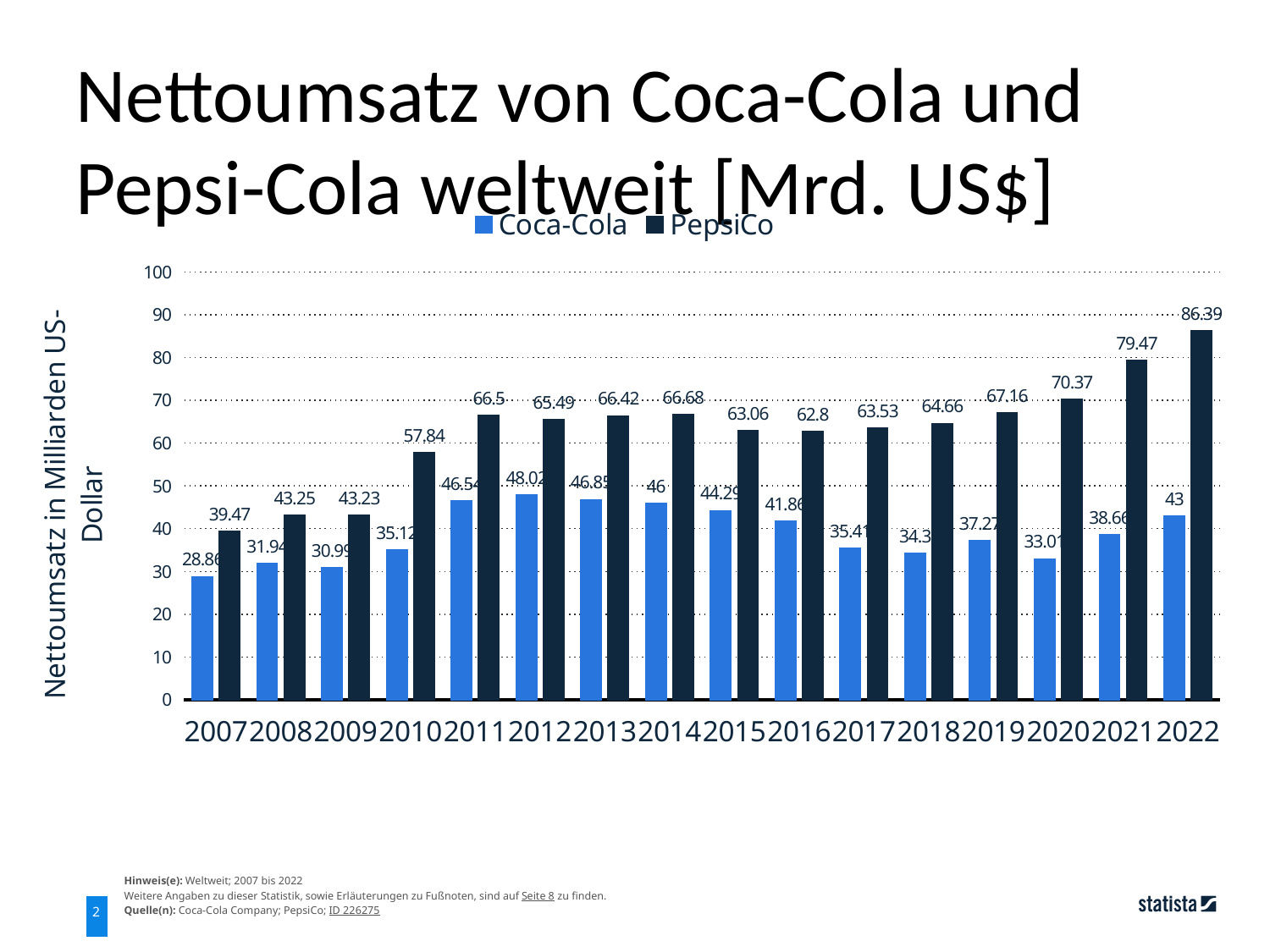
What was PepsiCo's net revenue in 2010? 57.84 How many years are shown on the x axis? 16 In which year was PepsiCo's net revenue highest? 2022 What was Coca-Cola's net revenue in 2022? 43 What is the difference between PepsiCo's and Coca-Cola's net revenue in 2022? 43.39 Is PepsiCo's net revenue in 2021 greater or less than 70? greater What kind of chart is shown on the slide? Bar chart What was Coca-Cola's net revenue in 2014? 46 Which was larger in 2008: Coca-Cola's or PepsiCo's net revenue? PepsiCo How many series does the legend list? 2 What was PepsiCo's net revenue in 2022? 86.39 In which year was PepsiCo's net revenue lowest? 2007